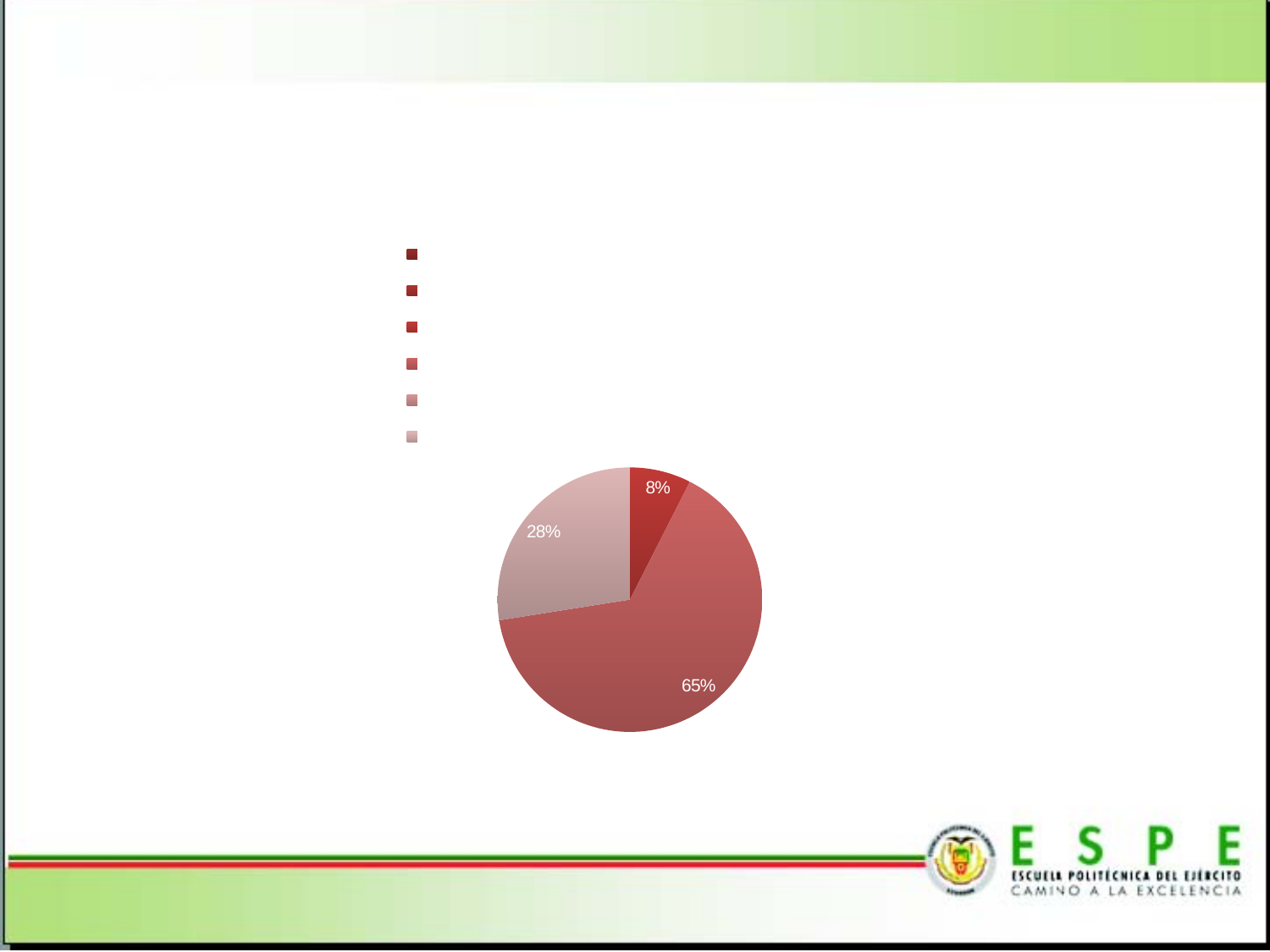
What is the value of the smallest slice of the pie chart? 8% How many slices with data labels does the pie chart show? 3 How many legend markers are shown above the pie chart? 6 Which slice of the pie chart is the lightest in colour? 28% Which is larger, the slice labelled 28% or the slice labelled 8%? 28% What is the difference between the largest slice (65%) and the smallest slice (8%) of the pie chart? 57% Is the largest slice of the pie chart greater or less than 50%? greater What is the difference between the 65% slice and the 28% slice of the pie chart? 37% What is the value of the largest slice of the pie chart? 65% What kind of chart is shown on the slide? pie chart What share of the pie does the second-largest slice represent? 28%